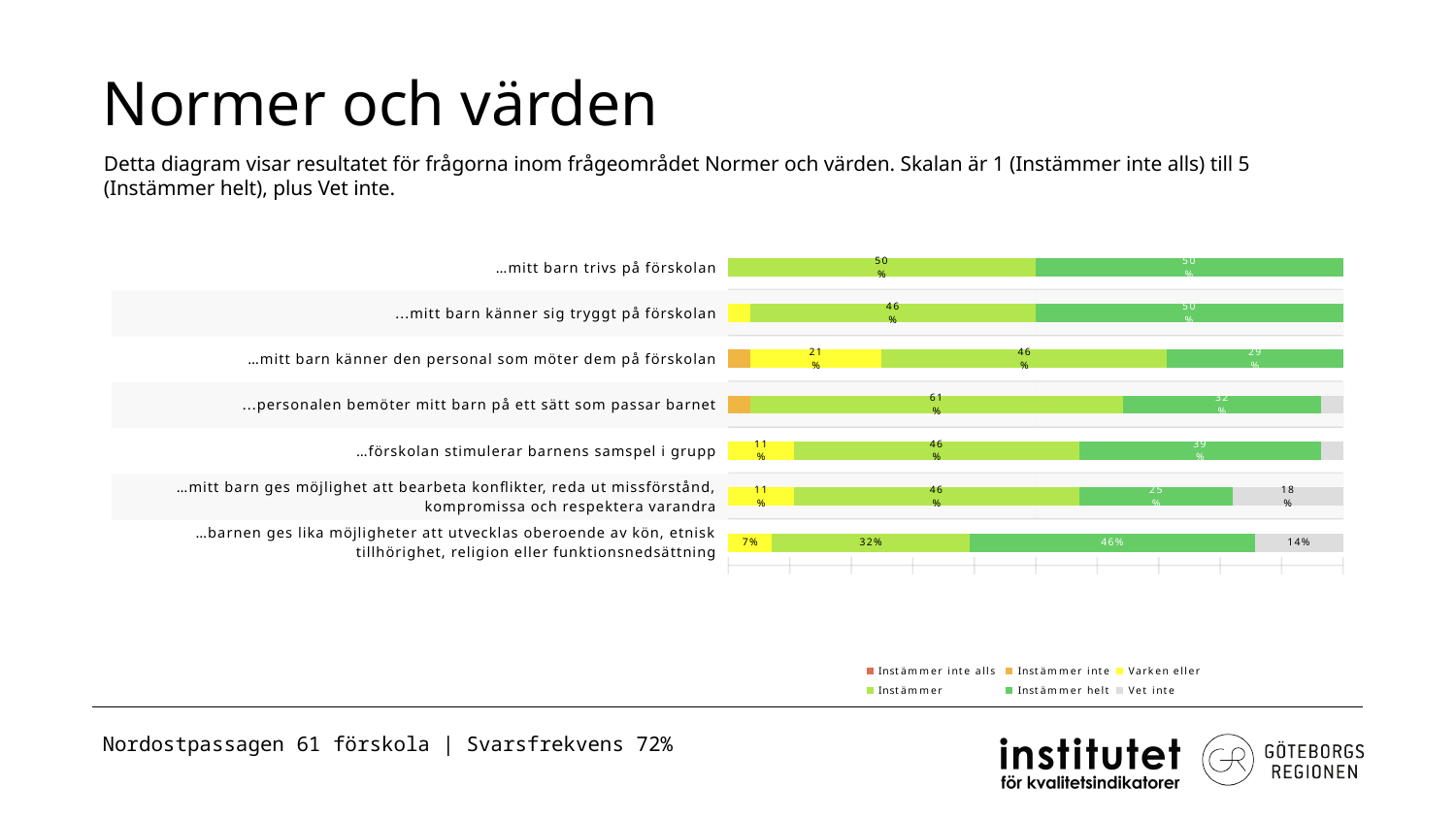
What is the 'Varken eller' value for '…mitt barn känner den personal som möter dem på förskolan'? 21% What is the title of the slide containing the chart? Normer och värden What is the 'Instämmer helt' value for '…mitt barn trivs på förskolan'? 50% How many statements (categories) are plotted in the chart? 7 Which is larger for '…barnen ges lika möjligheter att utvecklas oberoende av kön, etnisk tillhörighet, religion eller funktionsnedsättning': the 'Instämmer' value or the 'Instämmer helt' value? Instämmer helt What kind of chart is shown on the slide? Stacked bar chart How many series does the legend list? 6 Which statement has the lowest 'Instämmer helt' value? …mitt barn ges möjlighet att bearbeta konflikter, reda ut missförstånd, kompromissa och respektera varandra What is the difference between the 'Instämmer helt' values for '…förskolan stimulerar barnens samspel i grupp' and '…mitt barn känner den personal som möter dem på förskolan'? 10% What is the 'Vet inte' value for '…mitt barn ges möjlighet att bearbeta konflikter, reda ut missförstånd, kompromissa och respektera varandra'? 18% Which statement has the highest 'Instämmer' value? …personalen bemöter mitt barn på ett sätt som passar barnet What is the 'Instämmer' value for '…personalen bemöter mitt barn på ett sätt som passar barnet'? 61%